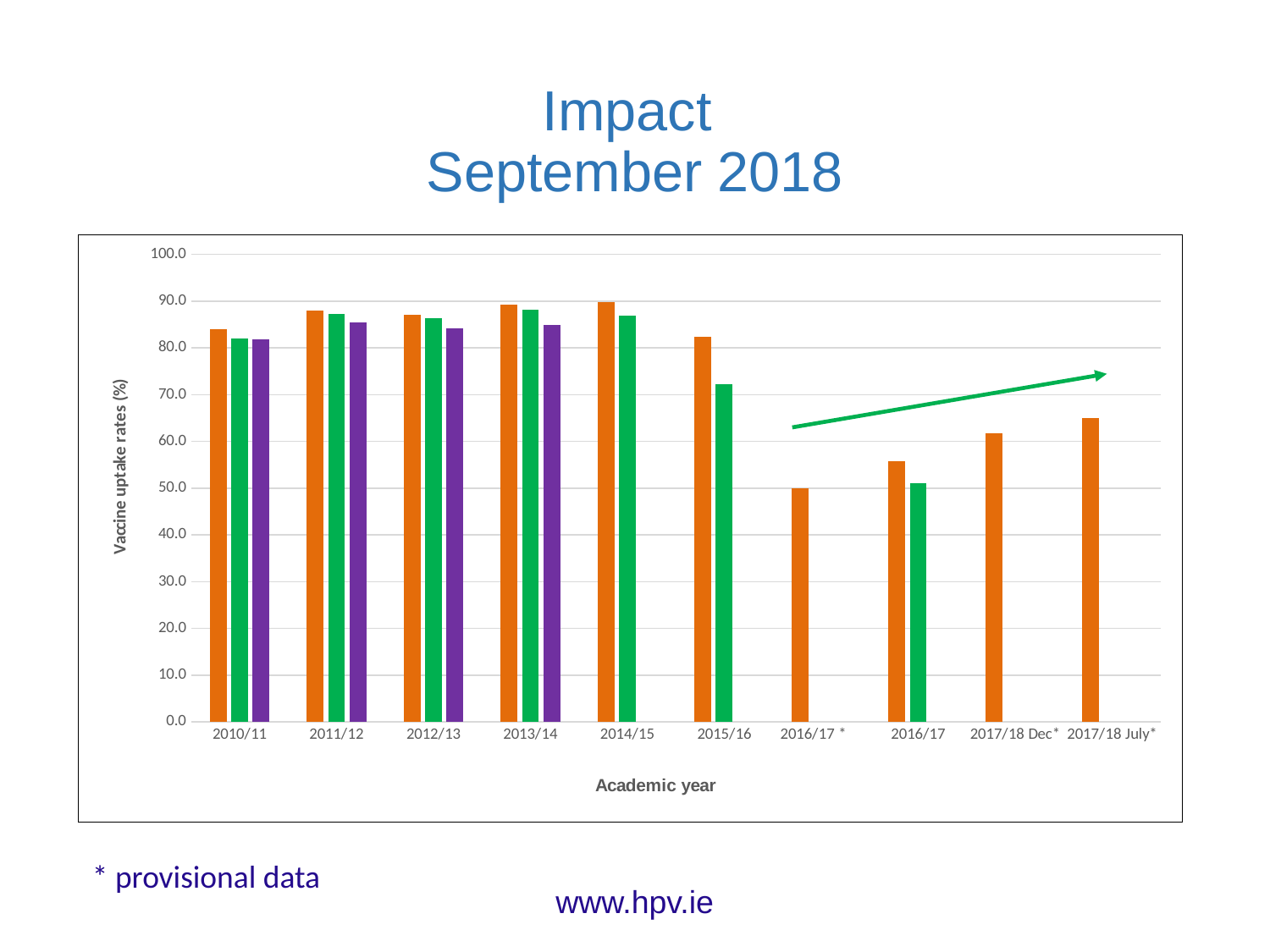
Which is larger, the orange bar for 2010/11 or the orange bar for 2016/17 *? 2010/11 Is the orange bar for 2017/18 July* greater or less than 60? greater What is the title of the vertical axis? Vaccine uptake rates (%) Is the green bar for 2015/16 greater or less than 70? greater Is the orange bar for 2010/11 greater or less than 80? greater What kind of chart is shown on the slide? bar chart Which academic year has the lowest orange bar? 2016/17 * How many academic year categories are shown on the x axis? 10 Do the orange bars rise or fall from 2016/17 * to 2017/18 July*? rise What is the title of the horizontal axis? Academic year